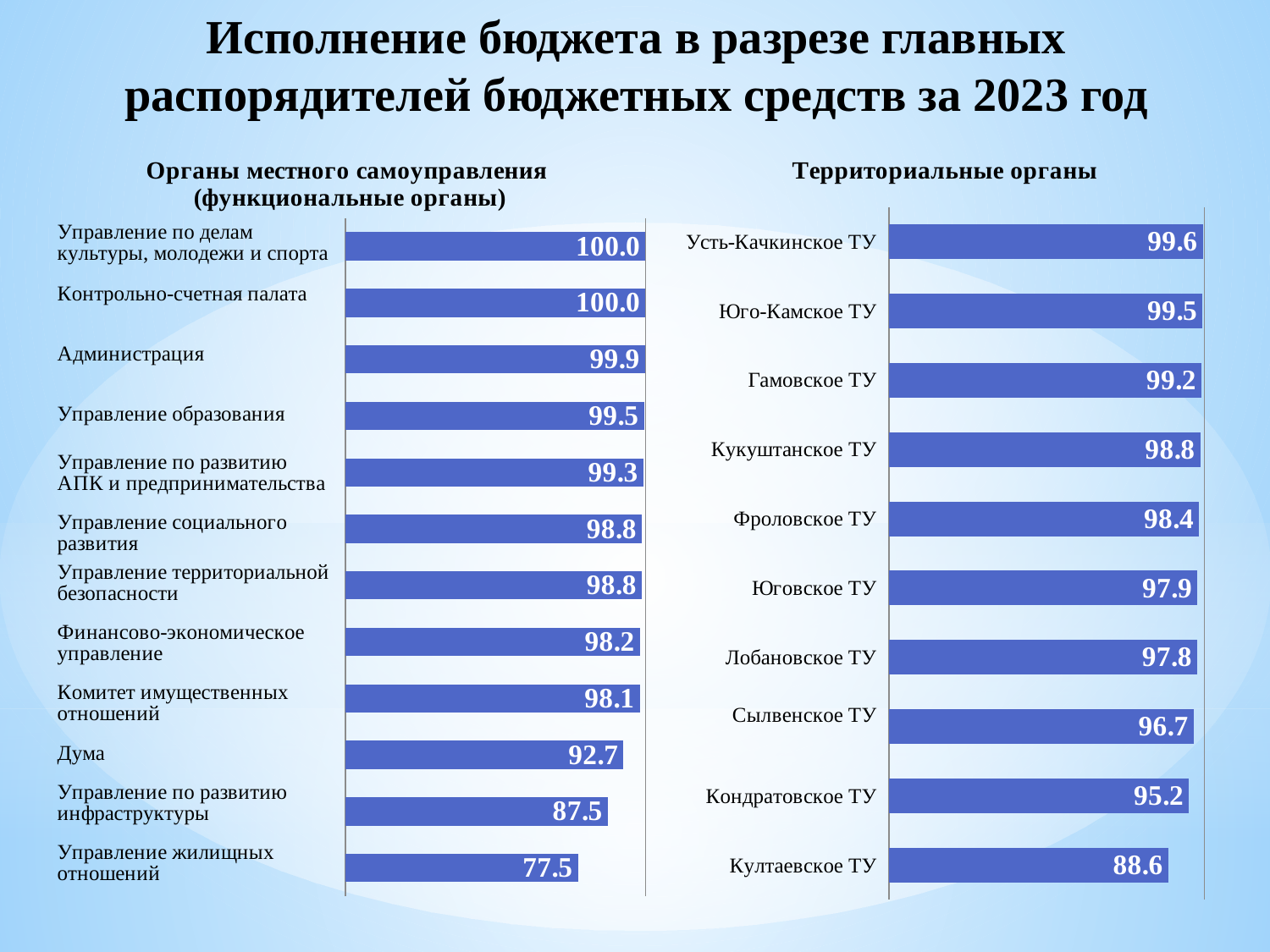
On the chart 'Органы местного самоуправления (функциональные органы)', what is the value for Управление образования? 99.5 On the chart 'Территориальные органы', how many categories are shown? 10 On the chart 'Территориальные органы', which is larger: Кондратовское ТУ or Лобановское ТУ? Лобановское ТУ On the chart 'Органы местного самоуправления (функциональные органы)', what is the value for Дума? 92.7 On the chart 'Органы местного самоуправления (функциональные органы)', what is the difference between Дума and Управление жилищных отношений? 15.2 On the chart 'Территориальные органы', what is the difference between Усть-Качкинское ТУ and Култаевское ТУ? 11.0 On the chart 'Территориальные органы', which category has the lowest value? Култаевское ТУ What type of chart is used on the slide for 'Территориальные органы'? Bar chart On the chart 'Органы местного самоуправления (функциональные органы)', how many categories are shown? 12 On the chart 'Территориальные органы', which category has the highest value? Усть-Качкинское ТУ On the chart 'Органы местного самоуправления (функциональные органы)', which category has the lowest value? Управление жилищных отношений On the chart 'Территориальные органы', what is the value for Сылвенское ТУ? 96.7